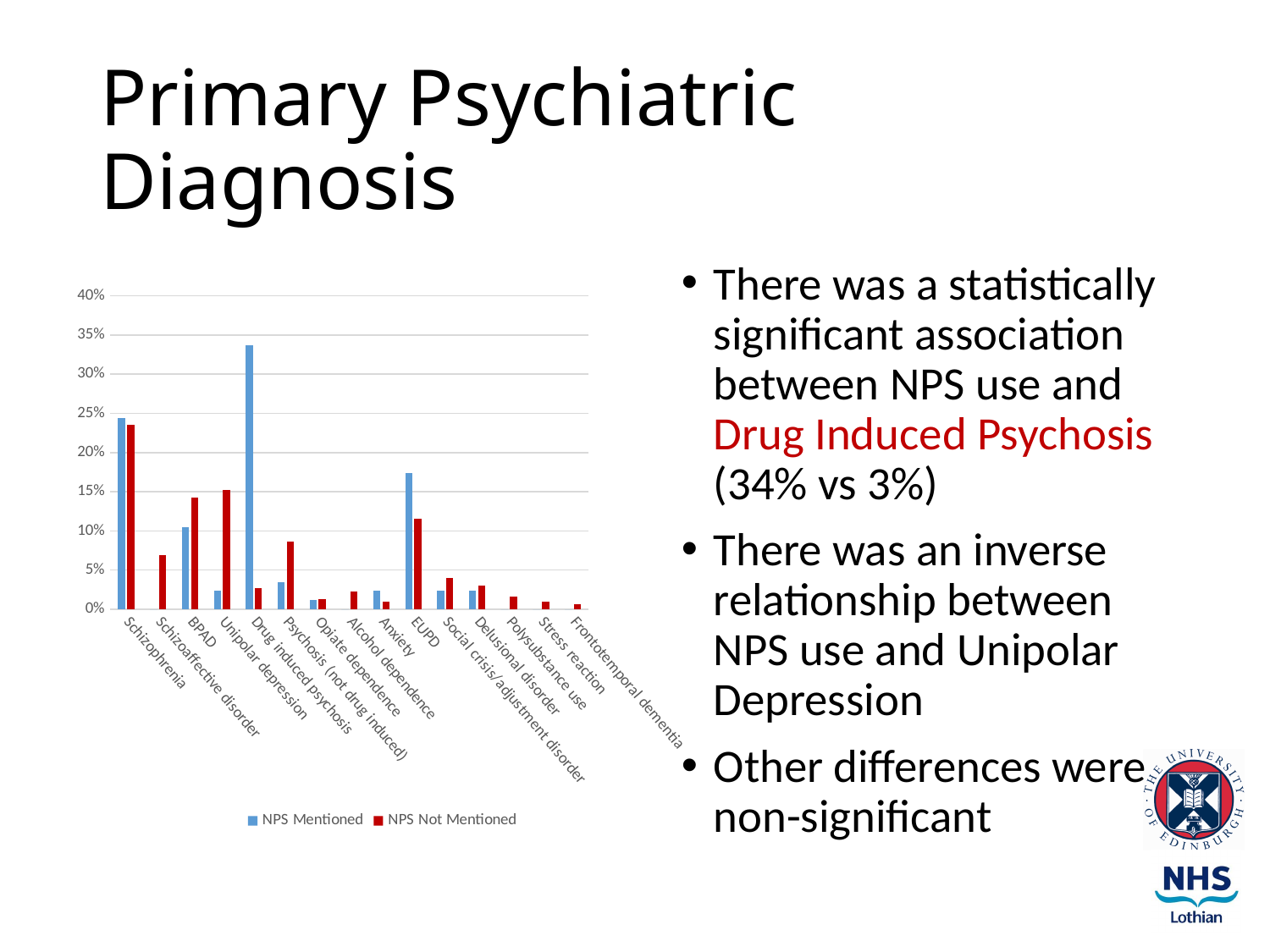
Which diagnosis has the highest value for the NPS Not Mentioned series? Schizophrenia How many diagnosis categories are shown on the x axis of the chart? 15 Is the NPS Mentioned value for EUPD greater or less than 15%? greater Is the NPS Not Mentioned value for Drug induced psychosis greater or less than 5%? less What kind of chart is shown on the slide? Bar chart How many series does the chart legend list? 2 Is the NPS Not Mentioned value for BPAD greater or less than 10%? greater For Unipolar depression, which series has the larger value, NPS Mentioned or NPS Not Mentioned? NPS Not Mentioned What are the two series named in the chart legend? NPS Mentioned and NPS Not Mentioned For EUPD, which series has the larger value, NPS Mentioned or NPS Not Mentioned? NPS Mentioned Which diagnosis has the highest value for the NPS Mentioned series? Drug induced psychosis